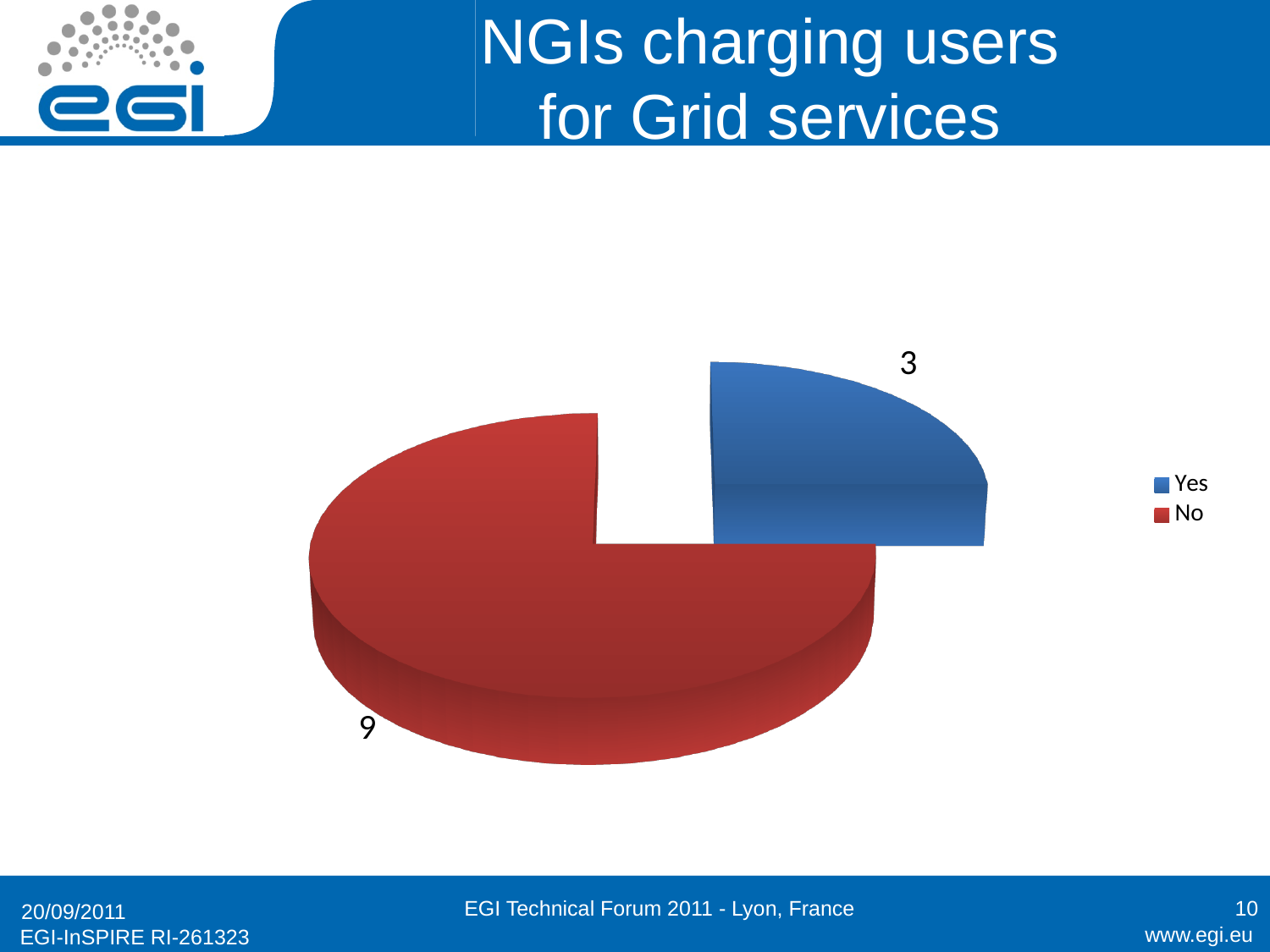
What is the total number of responses shown in the pie chart? 12 How many NGIs answered "Yes" to charging users for Grid services? 3 Which category has the smallest slice of the pie? Yes Which category has the largest slice of the pie? No How many NGIs answered "No" to charging users for Grid services? 9 How many categories does the pie chart have? 2 Which is larger, the "Yes" slice or the "No" slice? No What is the difference between the number of "No" and "Yes" responses? 6 What kind of chart is shown on the slide? pie chart How many entries does the legend list? 2 What colour is the "No" slice in the pie chart? red What share of the pie does the "Yes" slice represent? 25%